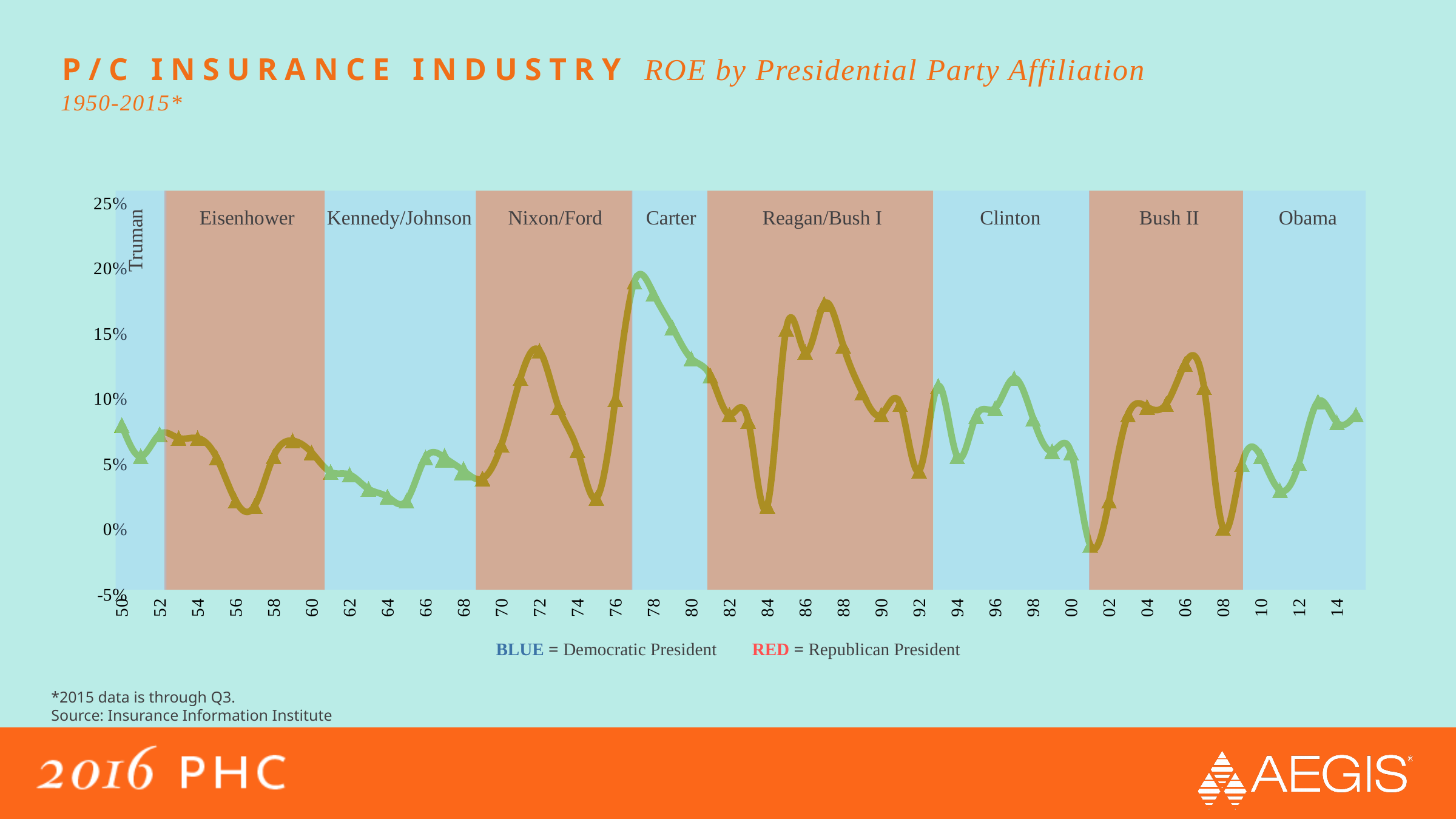
Does the ROE rise or fall from 1984 to 1987? rise According to the legend, what does blue shading indicate? Democratic President What is the title of the chart on the slide? P/C Insurance Industry ROE by Presidential Party Affiliation 1950-2015* How many presidential periods are labeled across the chart? 9 Which is higher, the ROE in 1977 or the ROE in 1987? 1977 Is the ROE value for 1987 greater or less than 15%? greater Is the ROE value for 1977 greater or less than 15%? greater Is the ROE value for 2001 greater or less than 0%? less In which year does the ROE reach its highest point on the chart? 1977 What kind of chart is shown on the slide? line chart